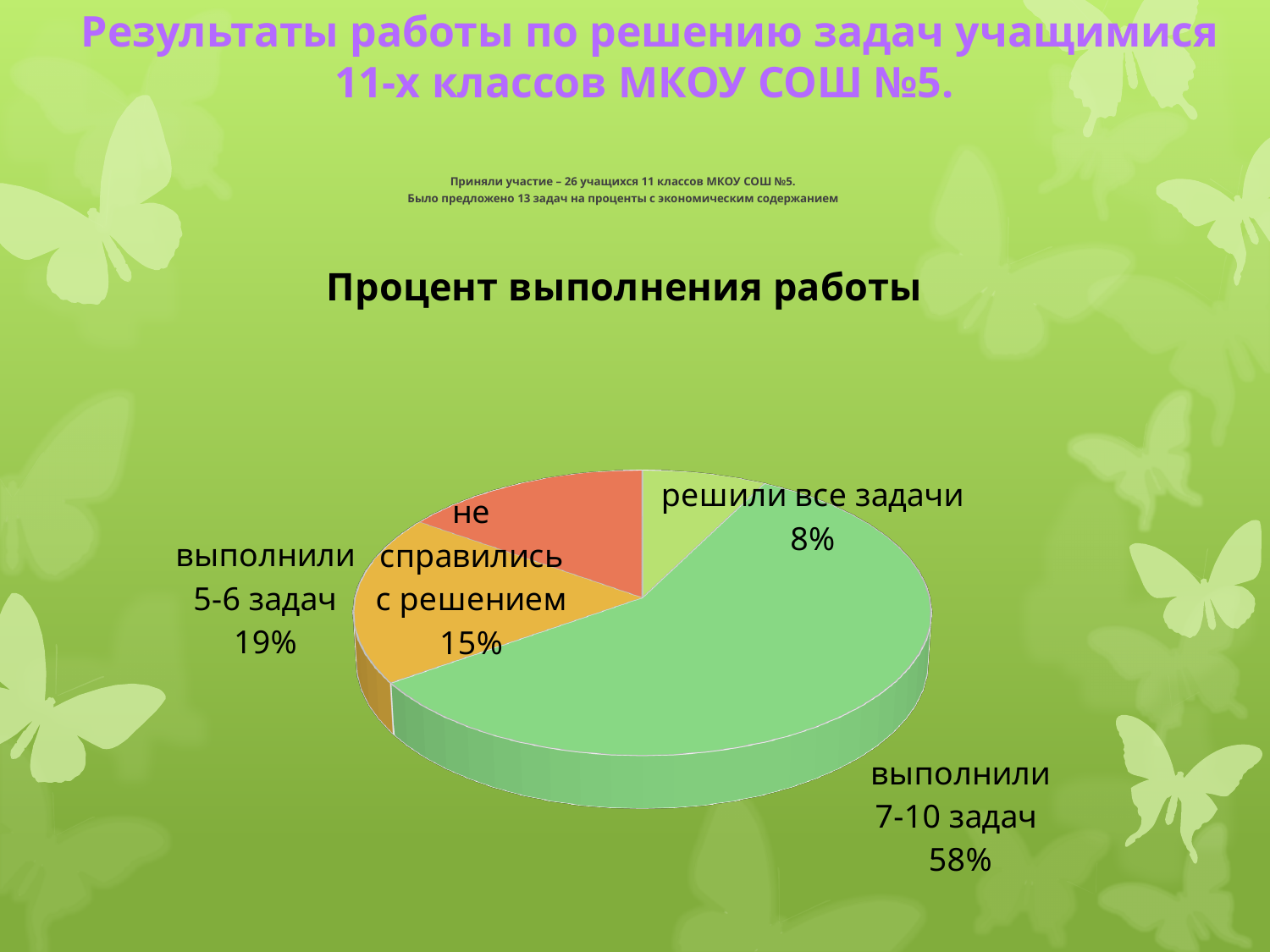
Which category has the largest slice of the pie? выполнили 7-10 задач What percentage of students did not cope with the solution (не справились с решением)? 15% What is the title of the chart? Процент выполнения работы What type of chart is shown on the slide? pie chart Which is larger: the share for 'выполнили 5-6 задач' or for 'не справились с решением'? выполнили 5-6 задач What percentage of students solved all the problems (решили все задачи)? 8% What colour is the slice for 'не справились с решением'? red/orange What percentage is shown for 'выполнили 5-6 задач'? 19% Which category has the smallest slice of the pie? решили все задачи How many categories are shown in the pie chart? 4 What share of the pie corresponds to 'выполнили 7-10 задач'? 58% What is the difference in percentage points between 'выполнили 7-10 задач' and 'выполнили 5-6 задач'? 39